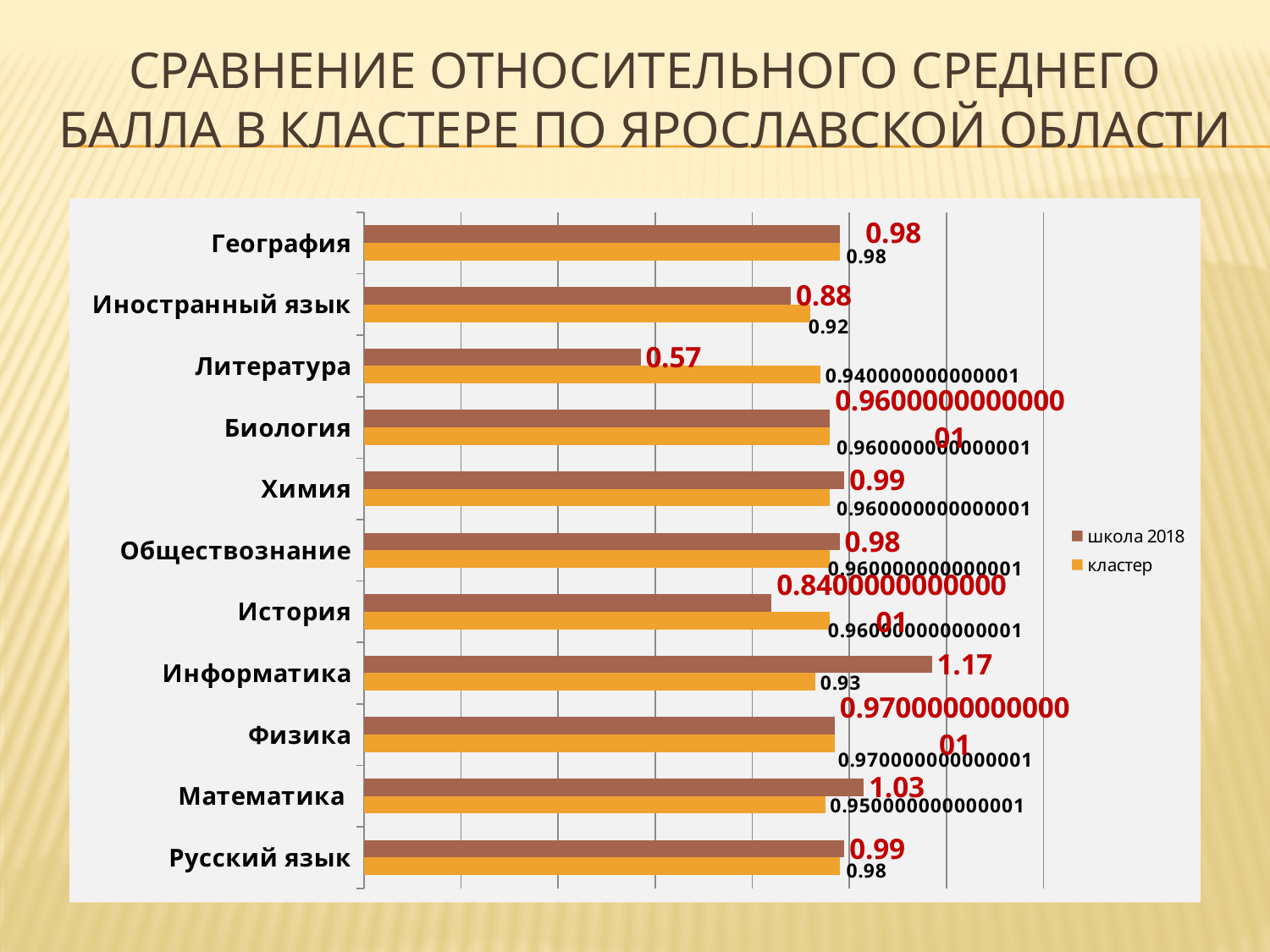
What is the value for Литература in the школа 2018 series? 0.57 Which subject has the highest value in the школа 2018 series? Информатика What is the difference between the школа 2018 and кластер values for Информатика? 0.24 Which series is shown in orange? кластер Which subject has the lowest value in the школа 2018 series? Литература What is the value for Иностранный язык in the кластер series? 0.92 How many subjects (categories) are shown on the chart? 11 What is the value for Информатика in the школа 2018 series? 1.17 What is the value for Математика in the школа 2018 series? 1.03 How many series does the legend list? 2 What kind of chart is shown on the slide? bar chart For Литература, which is larger: the школа 2018 value or the кластер value? кластер